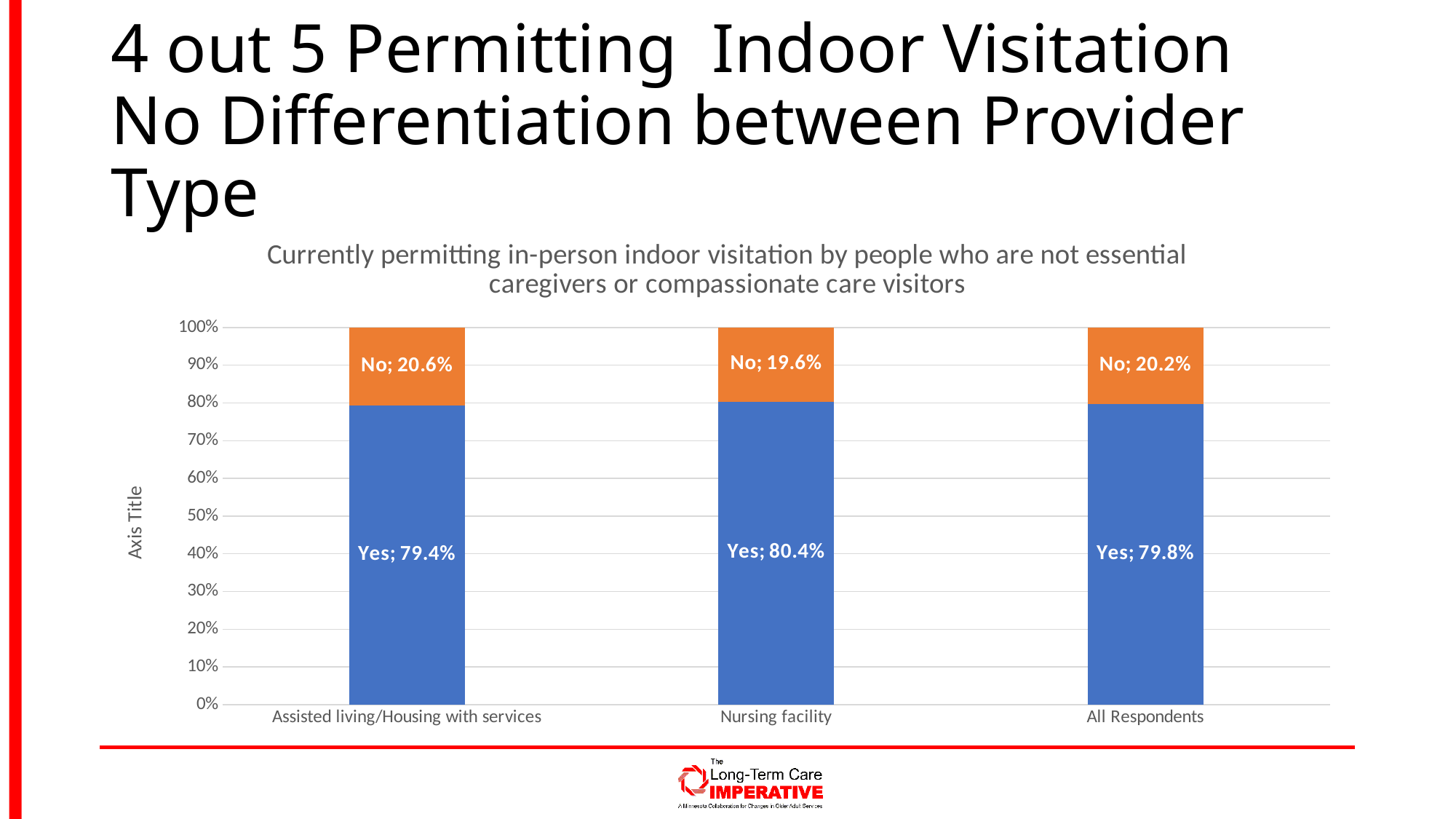
What is the Yes percentage for All Respondents? 79.8% Which category has the lowest No percentage? Nursing facility What percentage of Assisted living/Housing with services respondents answered Yes? 79.4% Is the Yes value for Assisted living/Housing with services greater or less than 70%? greater What is the No percentage for Assisted living/Housing with services? 20.6% What kind of chart is shown on the slide? Stacked bar chart What percentage of Nursing facility respondents answered No? 19.6% Which category has the highest Yes percentage? Nursing facility How many categories are shown on the x axis? 3 Which is larger: the No percentage for Assisted living/Housing with services or for All Respondents? Assisted living/Housing with services What is the total of the Yes and No segments for the Nursing facility bar? 100% What is the difference between the Yes percentage for Nursing facility and for Assisted living/Housing with services? 1.0%